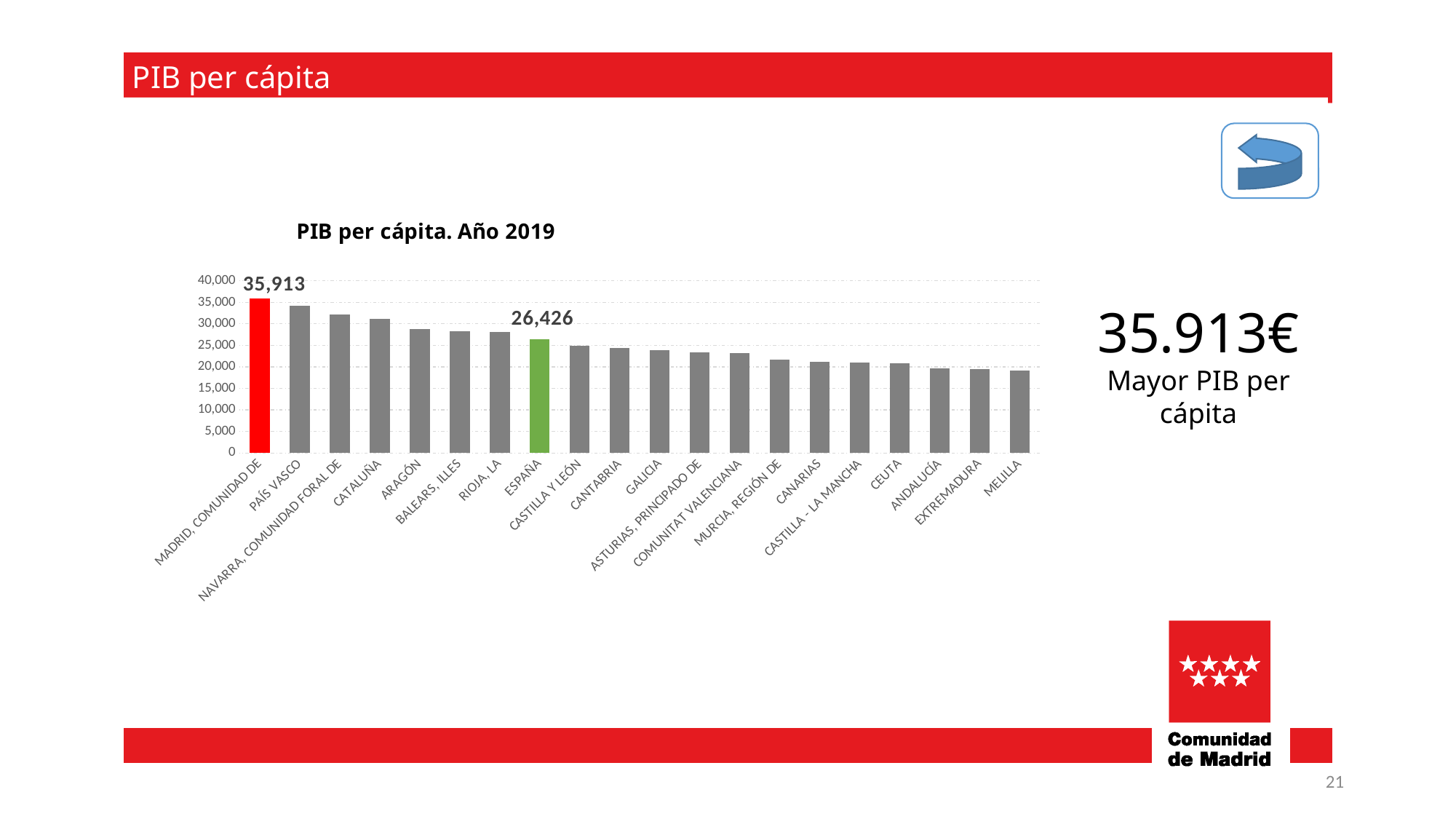
What is the value for MADRID, COMUNIDAD DE in the chart? 35,913 What kind of chart is shown on the slide? bar chart Which category has the highest value in the chart? MADRID, COMUNIDAD DE Is the value for PAÍS VASCO greater or less than 30,000? greater Is the value for MELILLA greater or less than 20,000? less How many bars are plotted in the chart? 20 Is the value for ARAGÓN greater or less than 25,000? greater What is the title of the chart? PIB per cápita. Año 2019 Do the values rise or fall from left to right along the x axis? fall Which has a larger value, PAÍS VASCO or CATALUÑA? PAÍS VASCO What is the difference between the values for MADRID, COMUNIDAD DE and ESPAÑA? 9,487 What is the value for ESPAÑA in the chart? 26,426